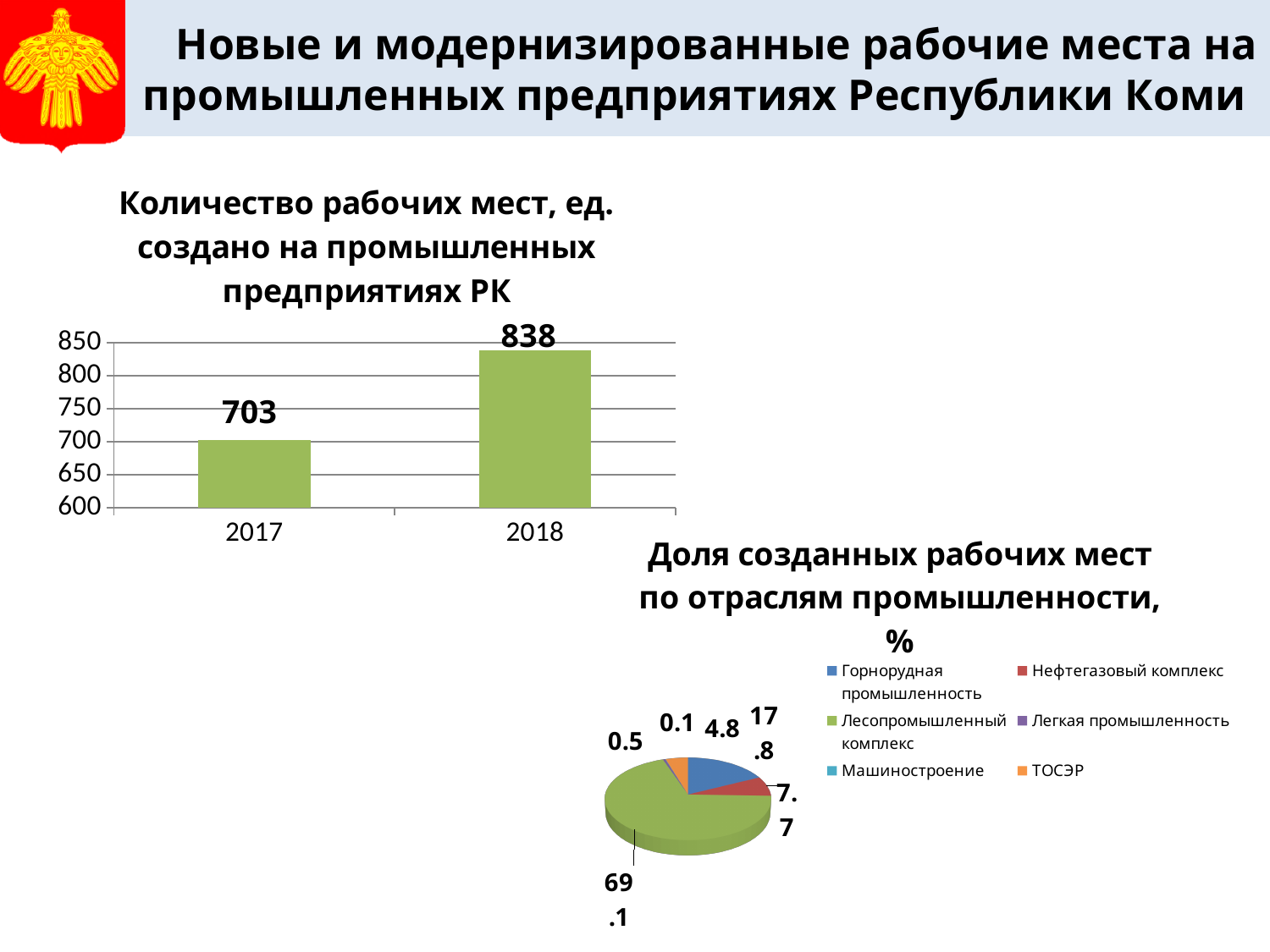
In the pie chart 'Доля созданных рабочих мест по отраслям промышленности, %', what is the share for Лесопромышленный комплекс? 69.1 In the bar chart 'Количество рабочих мест, ед. создано на промышленных предприятиях РК', by how much did the value increase from 2017 to 2018? 135 In the bar chart 'Количество рабочих мест, ед. создано на промышленных предприятиях РК', what is the value for 2017? 703 In the bar chart 'Количество рабочих мест, ед. создано на промышленных предприятиях РК', do the values rise or fall from 2017 to 2018? rise What type of chart is 'Количество рабочих мест, ед. создано на промышленных предприятиях РК'? bar chart In the bar chart 'Количество рабочих мест, ед. создано на промышленных предприятиях РК', what is the value for 2018? 838 In the pie chart 'Доля созданных рабочих мест по отраслям промышленности, %', what is the share for Горнорудная промышленность? 17.8 In the pie chart 'Доля созданных рабочих мест по отраслям промышленности, %', which sector has the largest share? Лесопромышленный комплекс In the pie chart 'Доля созданных рабочих мест по отраслям промышленности, %', what is the share for Нефтегазовый комплекс? 7.7 How many entries does the legend of the pie chart 'Доля созданных рабочих мест по отраслям промышленности, %' list? 6 How many categories are shown in the bar chart 'Количество рабочих мест, ед. создано на промышленных предприятиях РК'? 2 In the bar chart 'Количество рабочих мест, ед. создано на промышленных предприятиях РК', which year has the higher value? 2018